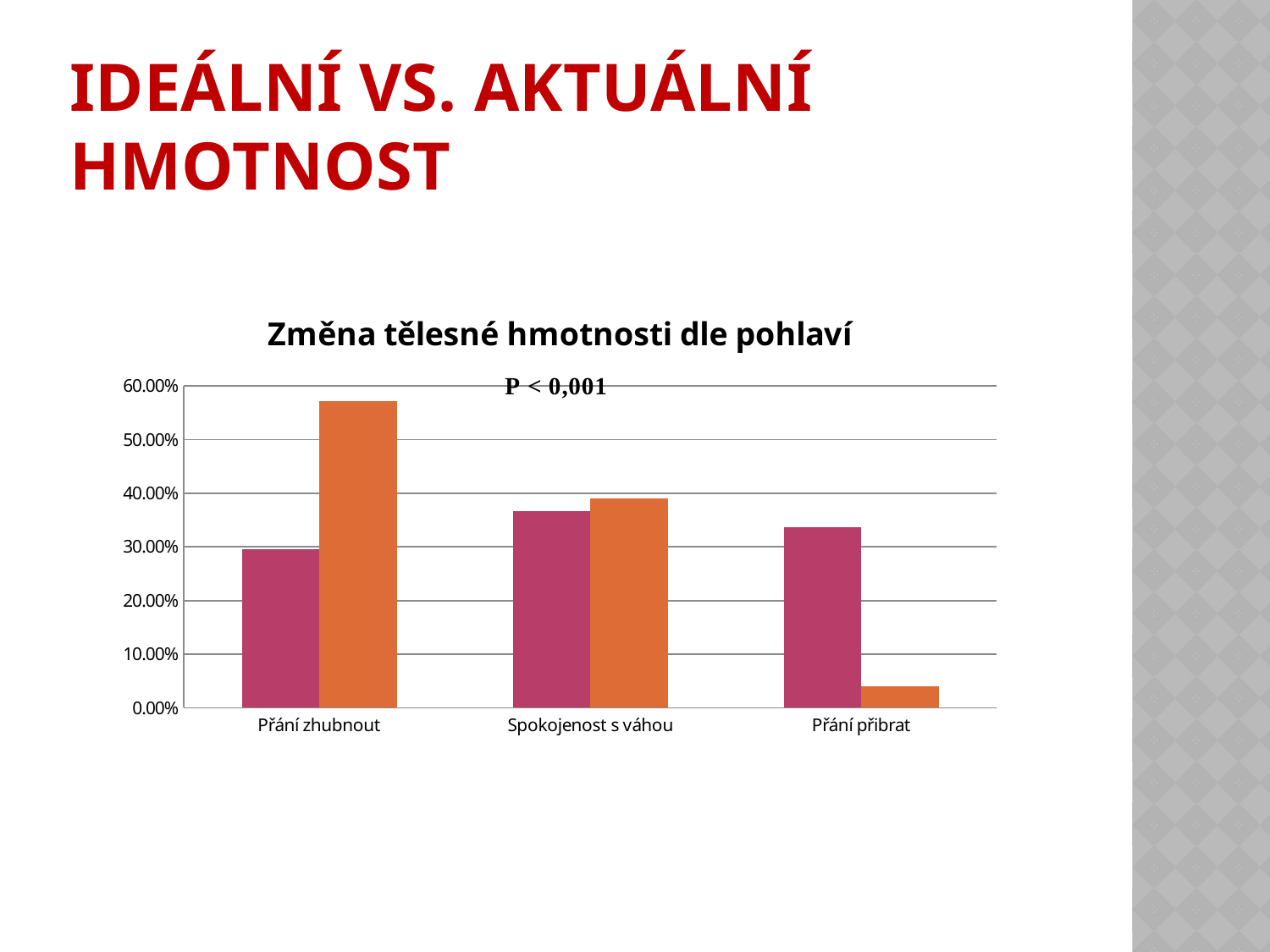
In the category Přání zhubnout, which bar is taller, the magenta one or the orange one? the orange one What kind of chart is shown on the slide? bar chart What is the title of the chart? Změna tělesné hmotnosti dle pohlaví Is the value of the orange bar for Přání přibrat greater or less than 10%? less In the category Přání přibrat, which bar is taller, the magenta one or the orange one? the magenta one What statistical annotation is printed inside the chart area? P < 0,001 Which category contains the shortest bar in the chart? Přání přibrat Which category has the tallest bar in the chart? Přání zhubnout How many categories are shown on the x axis of the chart? 3 Is the value of the orange bar for Přání zhubnout greater or less than 50%? greater Is the value of the magenta bar for Přání přibrat greater or less than 30%? greater Do the orange bars rise or fall from left to right across the categories? fall